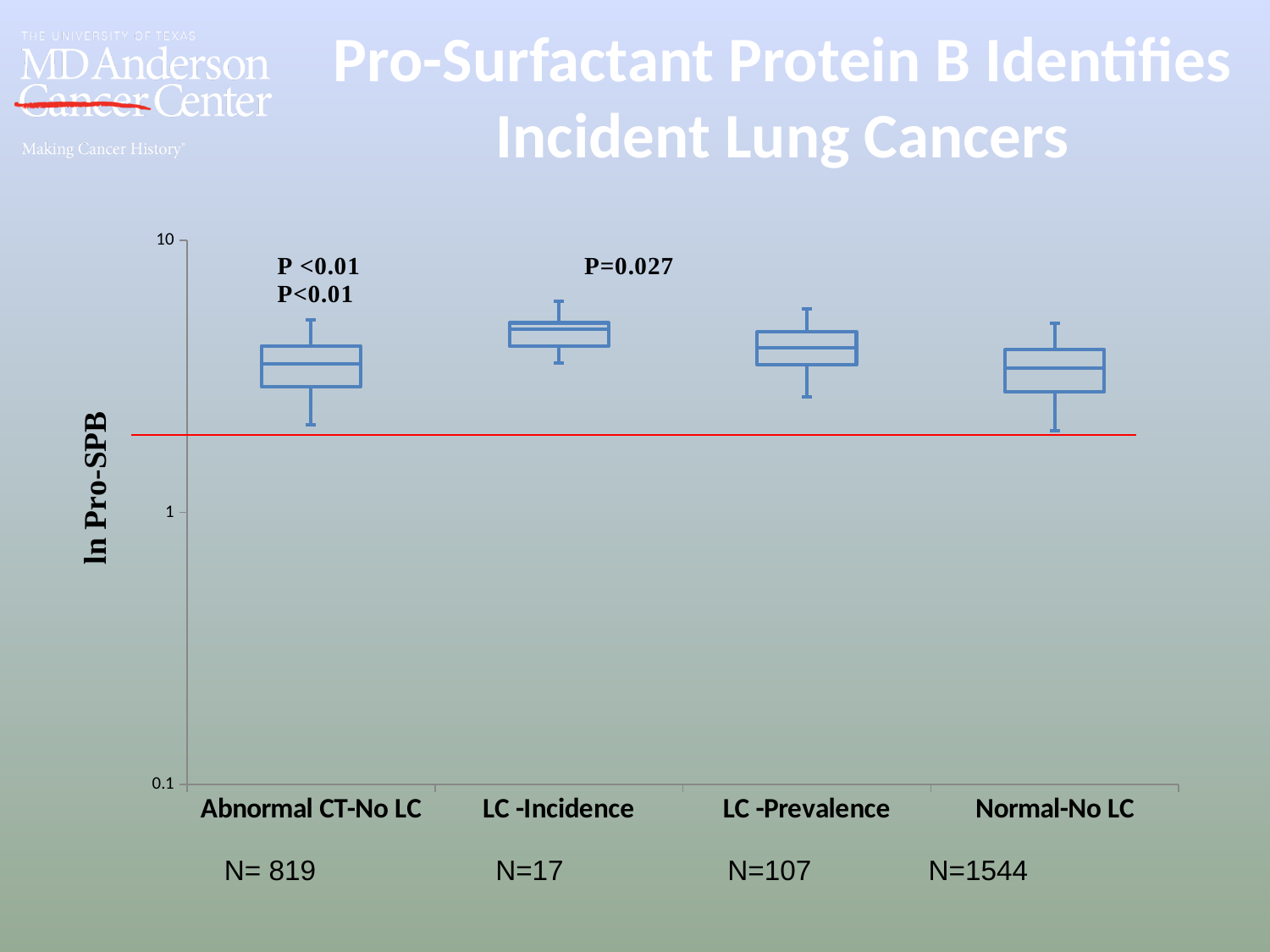
Is the median ln Pro-SPB for Normal-No LC greater or less than 10? less Which group has the higher median ln Pro-SPB, LC -Prevalence or Abnormal CT-No LC? LC -Prevalence What P value is annotated above the LC -Incidence box? P=0.027 Is the median ln Pro-SPB for LC -Incidence greater or less than 1? greater What kind of chart is shown on the slide? Box plot Which group has the higher median ln Pro-SPB, LC -Incidence or Normal-No LC? LC -Incidence What is the label on the y axis of the chart? ln Pro-SPB What is the sample size (N) shown for the LC -Prevalence group? N=107 What is the sample size (N) shown for the Normal-No LC group? N=1544 Which group has the highest median ln Pro-SPB? LC -Incidence What is the sample size (N) shown for the LC -Incidence group? N=17 How many groups are plotted along the x axis? 4